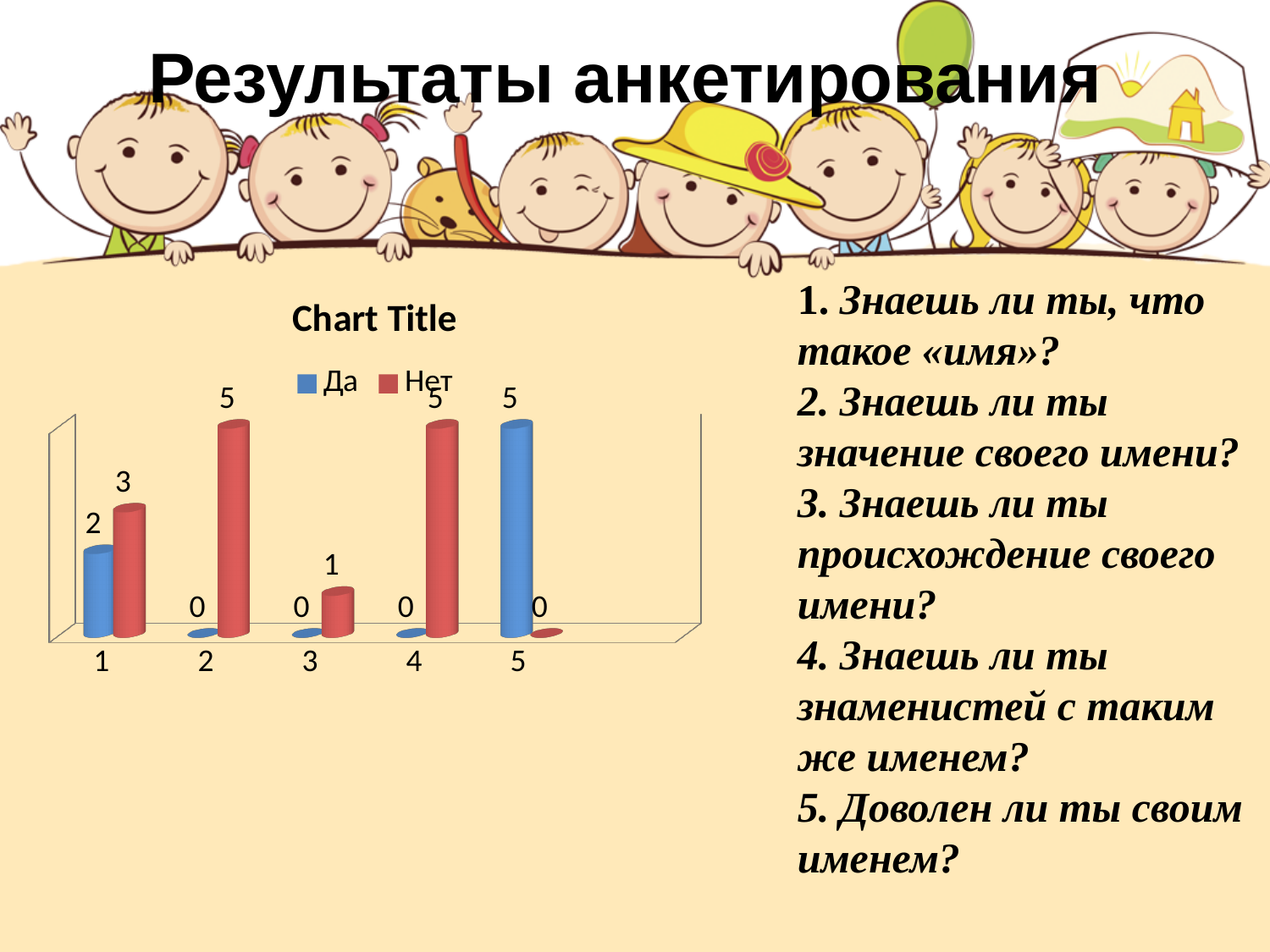
What is the value of the Нет series for category 2? 5 Which category has the lowest value in the Нет series? 5 How many categories are shown on the x axis? 5 What is the difference between the Нет and Да values for category 1? 1 How many series does the legend list? 2 Which category has the highest value in the Да series? 5 What is the value of the Да series for category 1? 2 What is the title of the chart? Chart Title What is the value of the Нет series for category 3? 1 For category 4, which series has the larger value, Да or Нет? Нет What kind of chart is shown on the slide? Bar chart What is the value of the Да series for category 5? 5